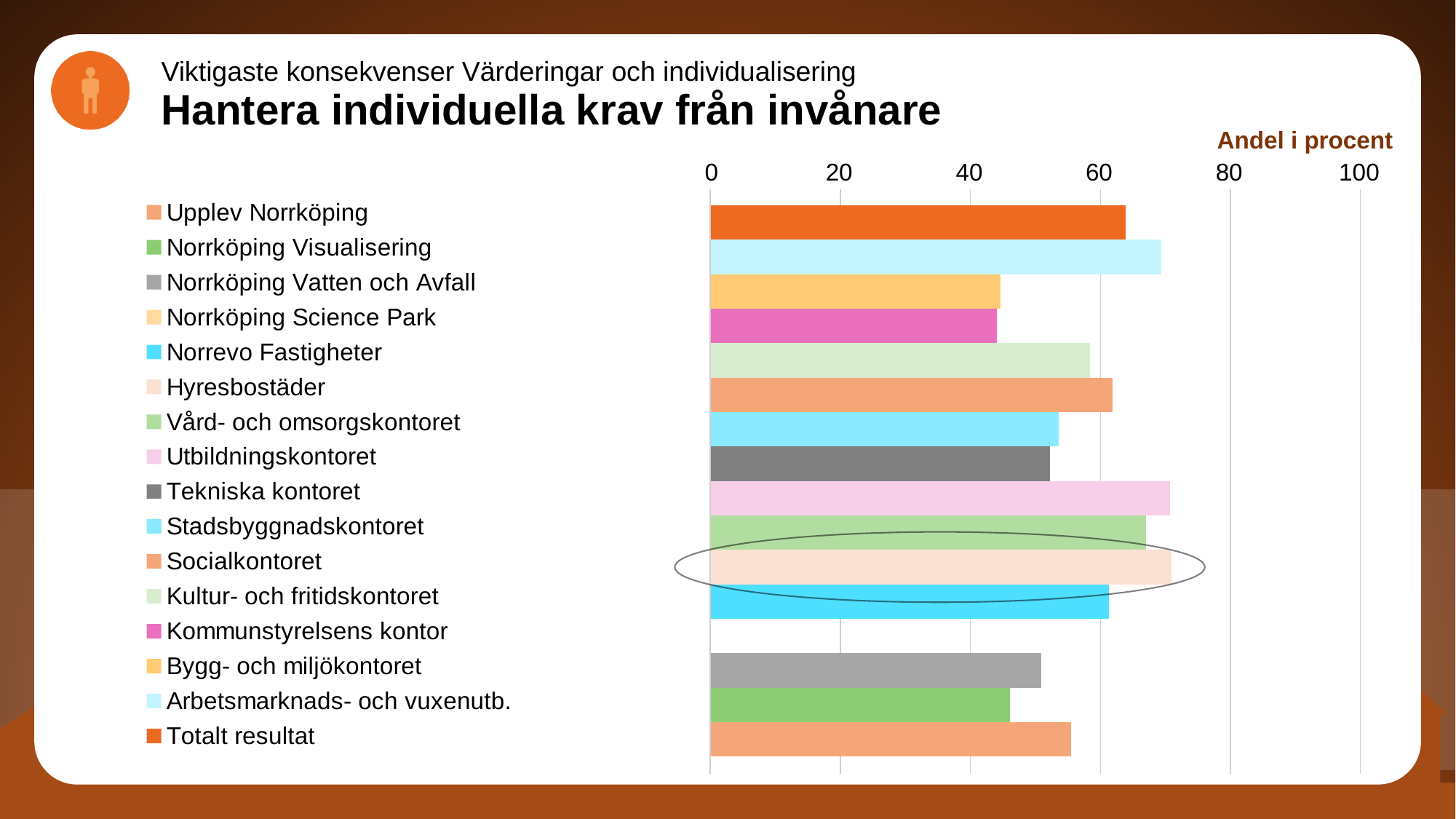
Which legend entry's bar is circled on the chart? Hyresbostäder Is the value for Totalt resultat greater or less than 60? greater Which has the larger value, Totalt resultat or Tekniska kontoret? Totalt resultat Is the value for Bygg- och miljökontoret greater or less than 60? less What is the title of the horizontal axis? Andel i procent What kind of chart is shown on the slide? bar chart How many entries does the legend list? 16 Is the value for Tekniska kontoret greater or less than 60? less Which has the larger value, Arbetsmarknads- och vuxenutb. or Bygg- och miljökontoret? Arbetsmarknads- och vuxenutb.